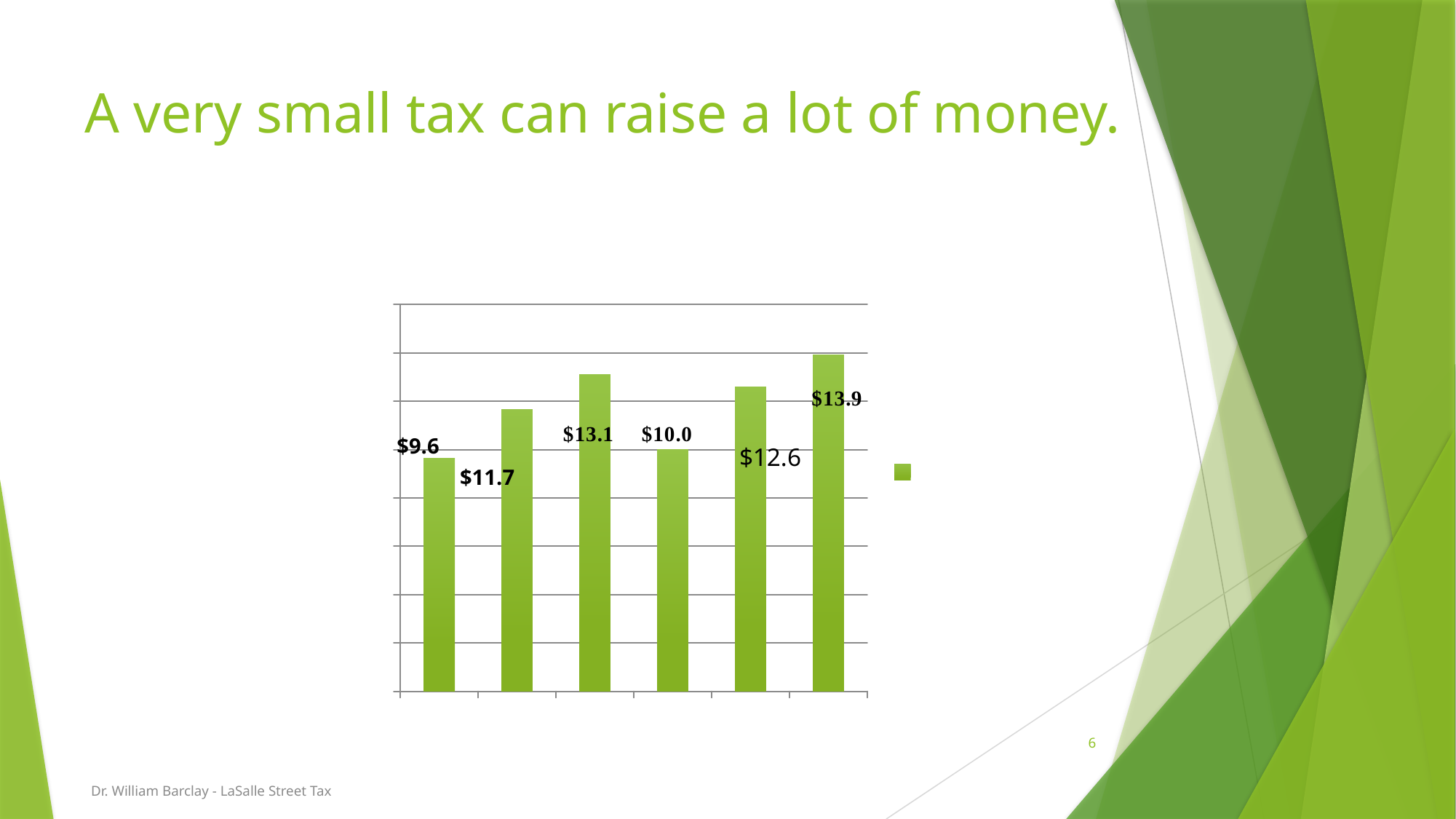
Which is larger, the value of the second bar or the value of the fourth bar? The second bar ($11.7) What is the value shown on the third bar from the left? $13.1 Which bar has the lowest value, and what is it? The first (leftmost) bar, $9.6 What colour are the bars in the chart? Green How many bars are plotted in the chart? 6 What is the value shown on the first (leftmost) bar? $9.6 Does the chart show a title or category labels on the x axis? No What is the difference between the value of the sixth bar ($13.9) and the first bar ($9.6)? $4.3 Which bar has the highest value, and what is it? The sixth (rightmost) bar, $13.9 What is the difference between the third bar ($13.1) and the fourth bar ($10.0)? $3.1 What type of chart is shown on the slide? bar chart What is the value shown on the fifth bar from the left? $12.6